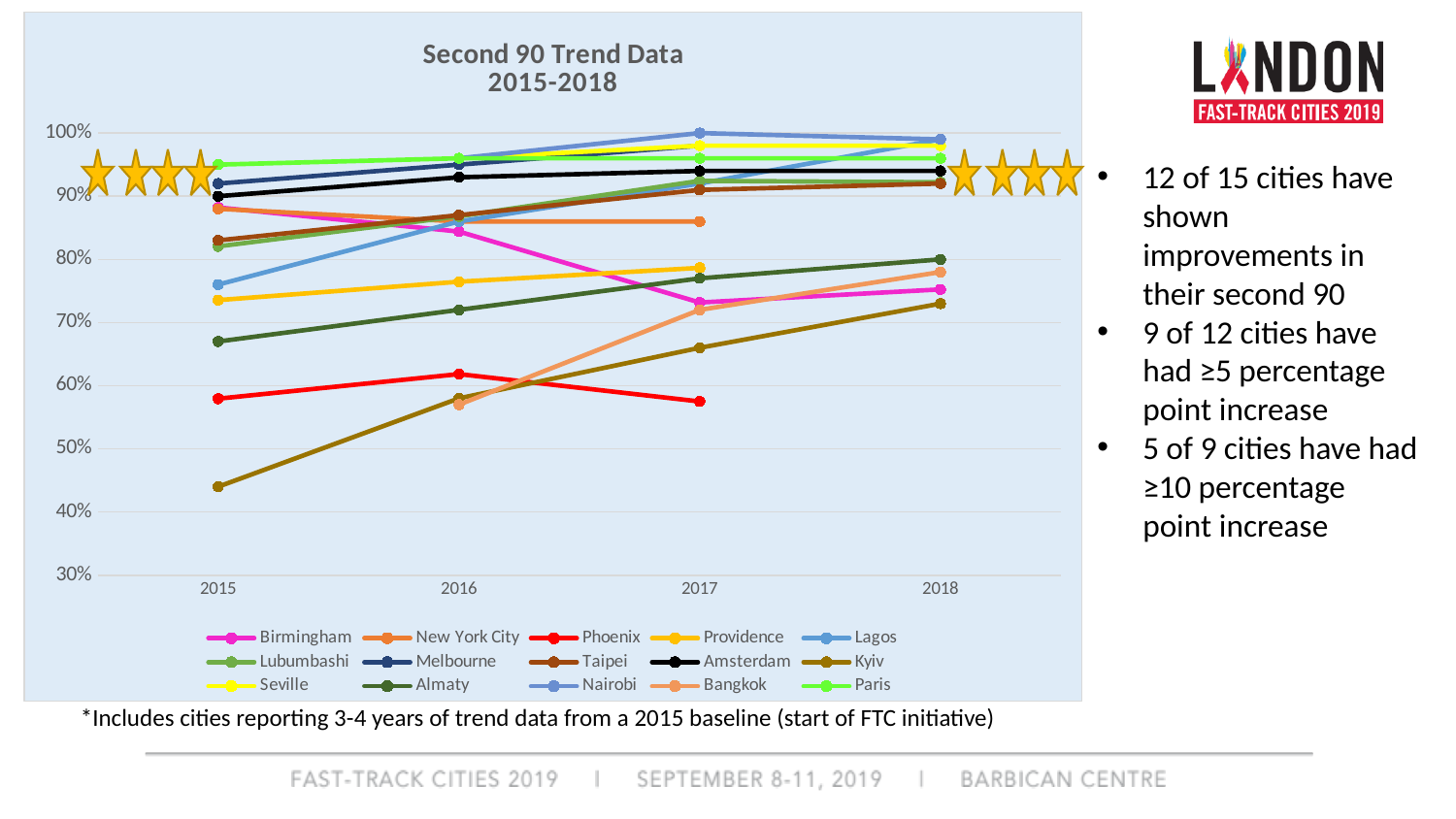
Which is larger in 2015, the value for Phoenix or the value for Kyiv? Phoenix How many series does the legend of the chart list? 15 Is the value for Phoenix in 2015 greater or less than 60%? less Is the value for Kyiv in 2015 greater or less than 50%? less Is the value for Almaty in 2015 greater or less than 70%? less What is the title of the chart? Second 90 Trend Data 2015-2018 Does the value for Kyiv rise or fall from 2015 to 2018? rise What kind of chart is shown on the slide? line chart Does the value for Birmingham rise or fall from 2015 to 2018? fall Which city has the lowest value in 2015? Kyiv How many years are shown along the x axis of the chart? 4